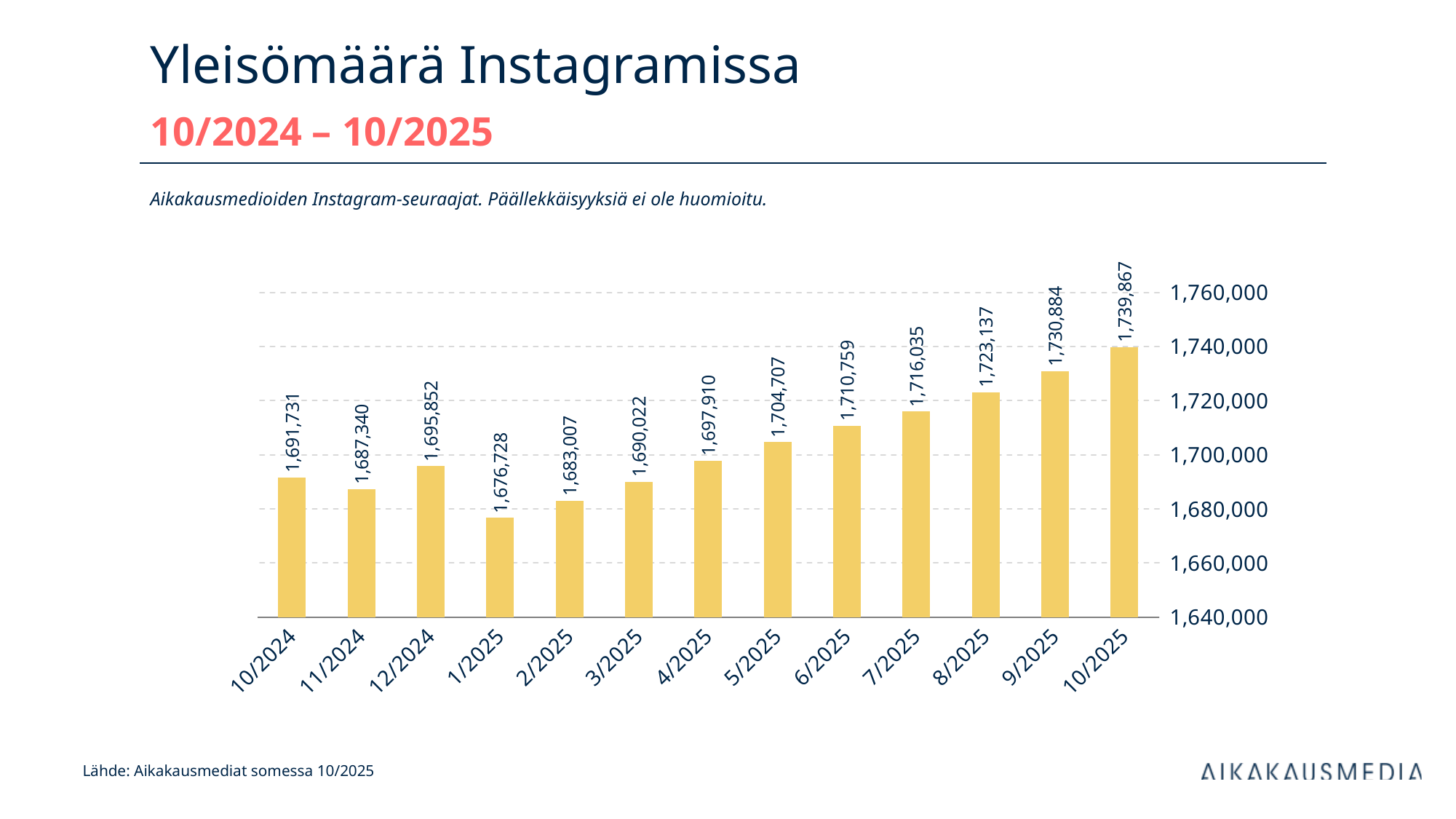
What is the value for 1/2025? 1,676,728 What is the value for 10/2024? 1,691,731 How many months are shown on the x axis? 13 What is the difference between the values for 10/2025 and 10/2024? 48,136 Which is larger, the value for 12/2024 or the value for 2/2025? 12/2024 Is the value for 7/2025 greater or less than 1,700,000? greater Which month has the lowest value? 1/2025 Which month has the highest value? 10/2025 What is the value for 6/2025? 1,710,759 Do the values rise or fall from 1/2025 to 10/2025? rise What is the difference between the values for 9/2025 and 8/2025? 7,747 What kind of chart is shown on the slide? bar chart